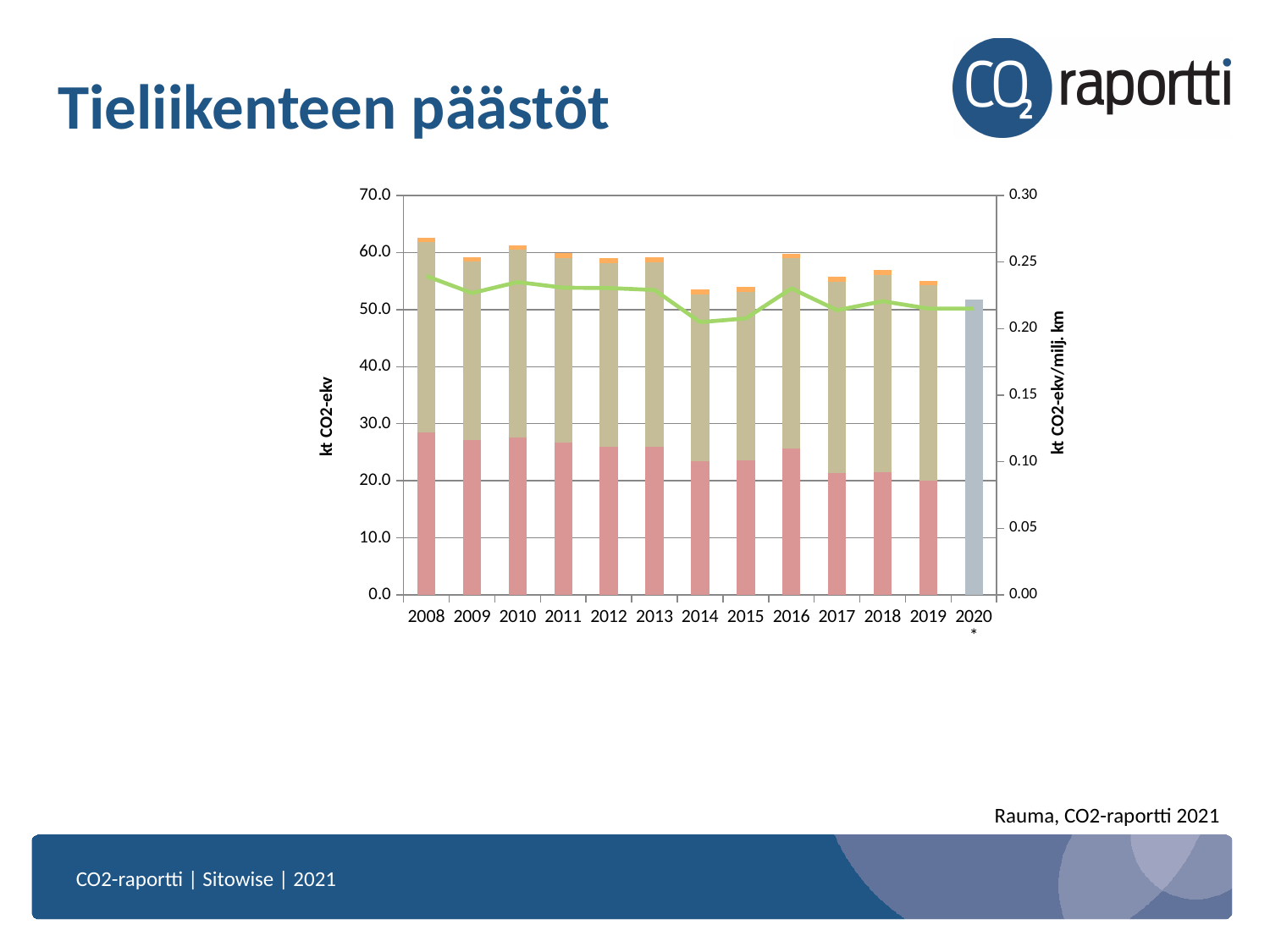
Which year has the tallest stacked bar? 2008 Does the line series generally rise or fall from 2008 to 2020? fall Is the total bar height for 2008 greater or less than 60.0 kt CO2-ekv? greater Is the bottom (pink) segment of the 2019 bar greater or less than 30.0 kt CO2-ekv? less Is the bar for 2020* greater or less than 50.0 kt CO2-ekv? greater How many years are shown on the x axis of the chart? 13 What kind of chart is shown on the slide? bar chart with a line Which year has the taller stacked bar, 2008 or 2014? 2008 What is the title of the right-hand vertical axis? kt CO2-ekv/milj. km